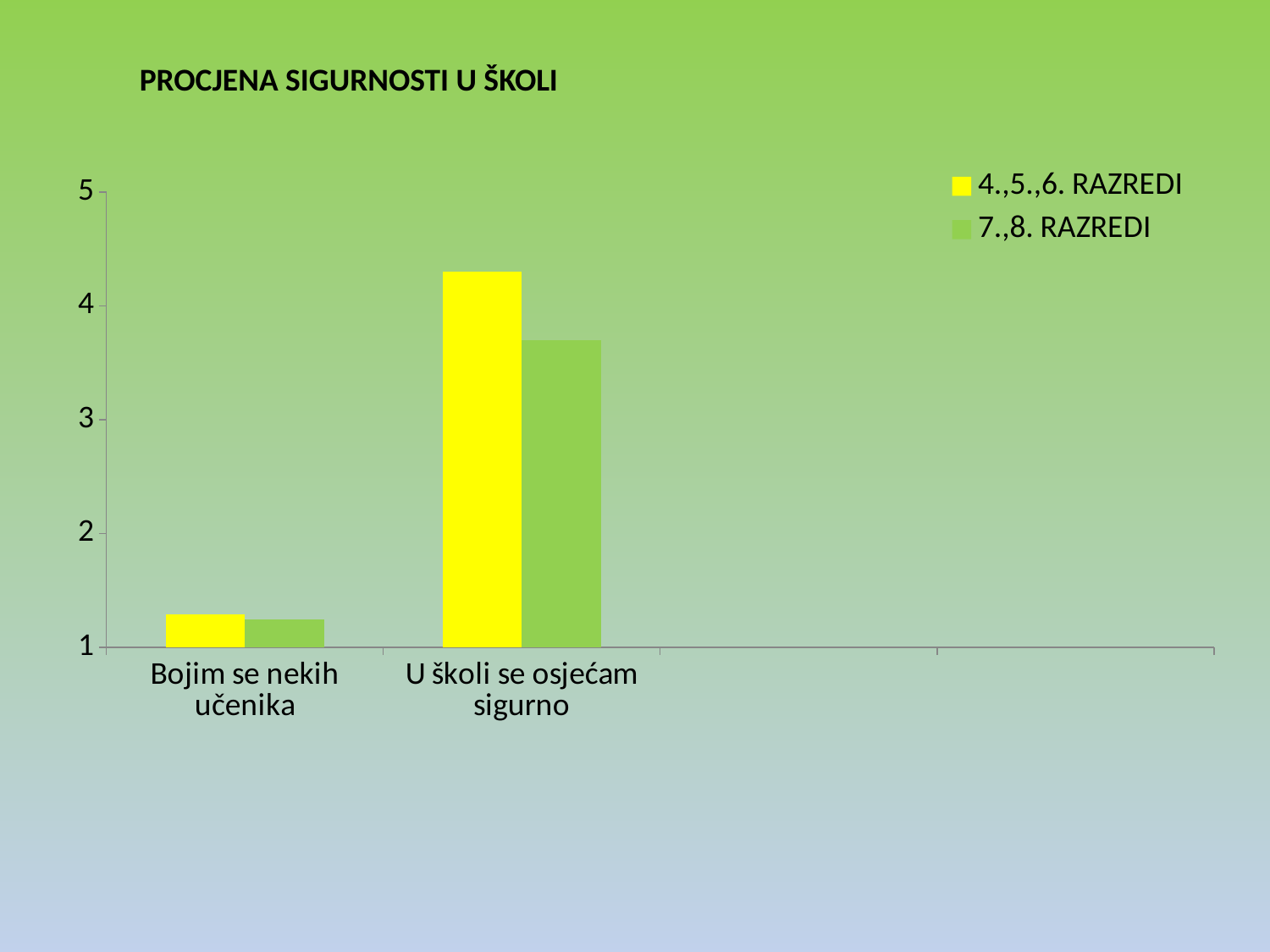
What kind of chart is shown on the slide? Bar chart What is the title of the chart? PROCJENA SIGURNOSTI U ŠKOLI Is the value for 4.,5.,6. RAZREDI in the category 'Bojim se nekih učenika' greater or less than 2? less For the series 4.,5.,6. RAZREDI, which category has the highest value? U školi se osjećam sigurno Is the value for 7.,8. RAZREDI in the category 'U školi se osjećam sigurno' greater or less than 3? greater Which series is shown in yellow? 4.,5.,6. RAZREDI In the category 'U školi se osjećam sigurno', which series has the larger value, 4.,5.,6. RAZREDI or 7.,8. RAZREDI? 4.,5.,6. RAZREDI Is the value for 7.,8. RAZREDI in the category 'U školi se osjećam sigurno' greater or less than 4? less For the series 7.,8. RAZREDI, which category has the lowest value? Bojim se nekih učenika How many categories are shown on the x axis? 2 How many series does the legend list? 2